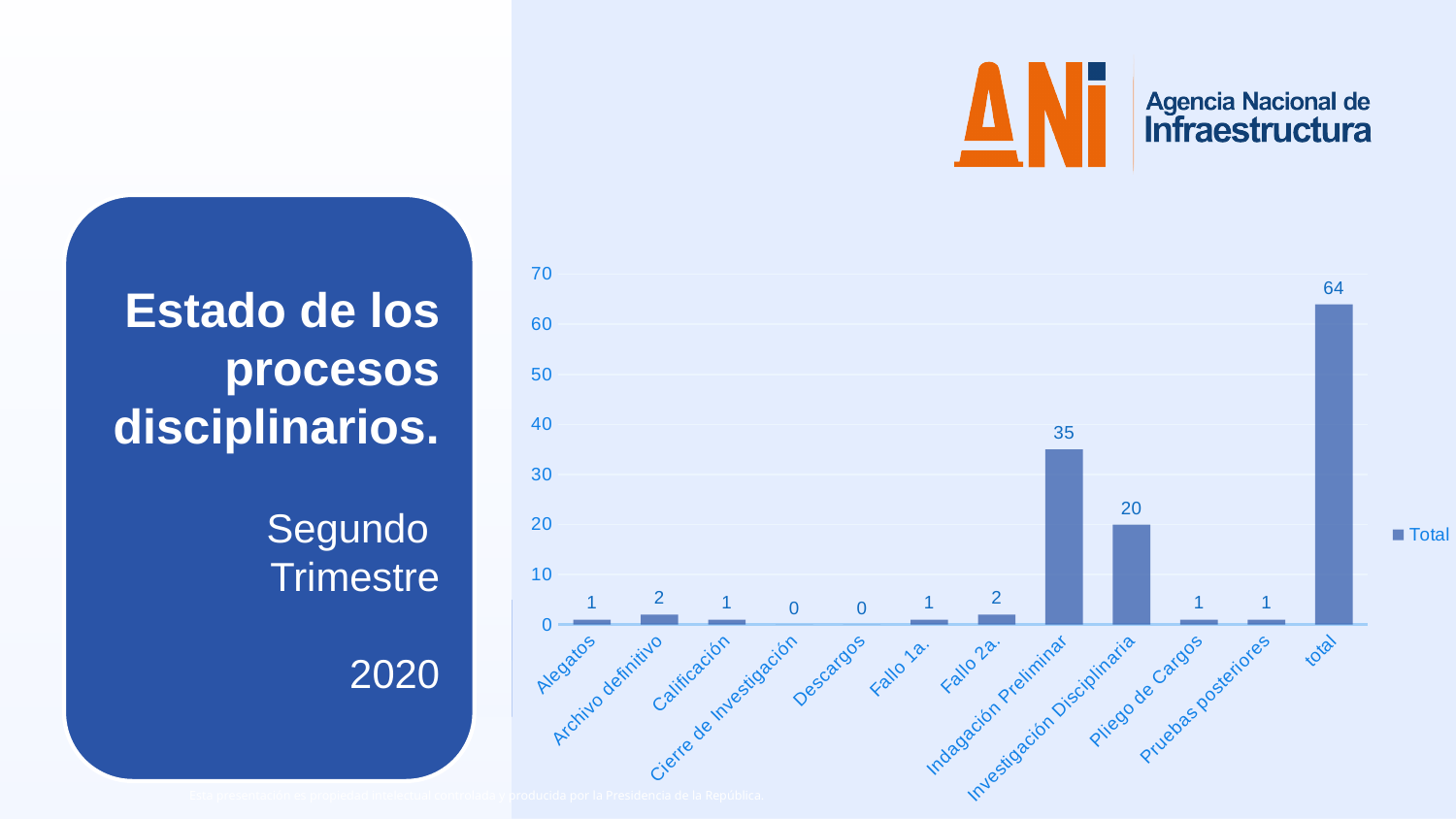
Is the value for Indagación Preliminar greater or less than 30? greater What is the value for Archivo definitivo? 2 How many series does the legend list? 1 What is the value for Indagación Preliminar? 35 What is the value for Descargos? 0 How many categories are shown on the x axis? 12 What kind of chart is shown on the slide? bar chart Which category has the highest bar? total What is the value shown for the 'total' bar? 64 Which is larger, Fallo 2a. or Fallo 1a.? Fallo 2a. What is the value for Investigación Disciplinaria? 20 What is the difference between Indagación Preliminar and Investigación Disciplinaria? 15